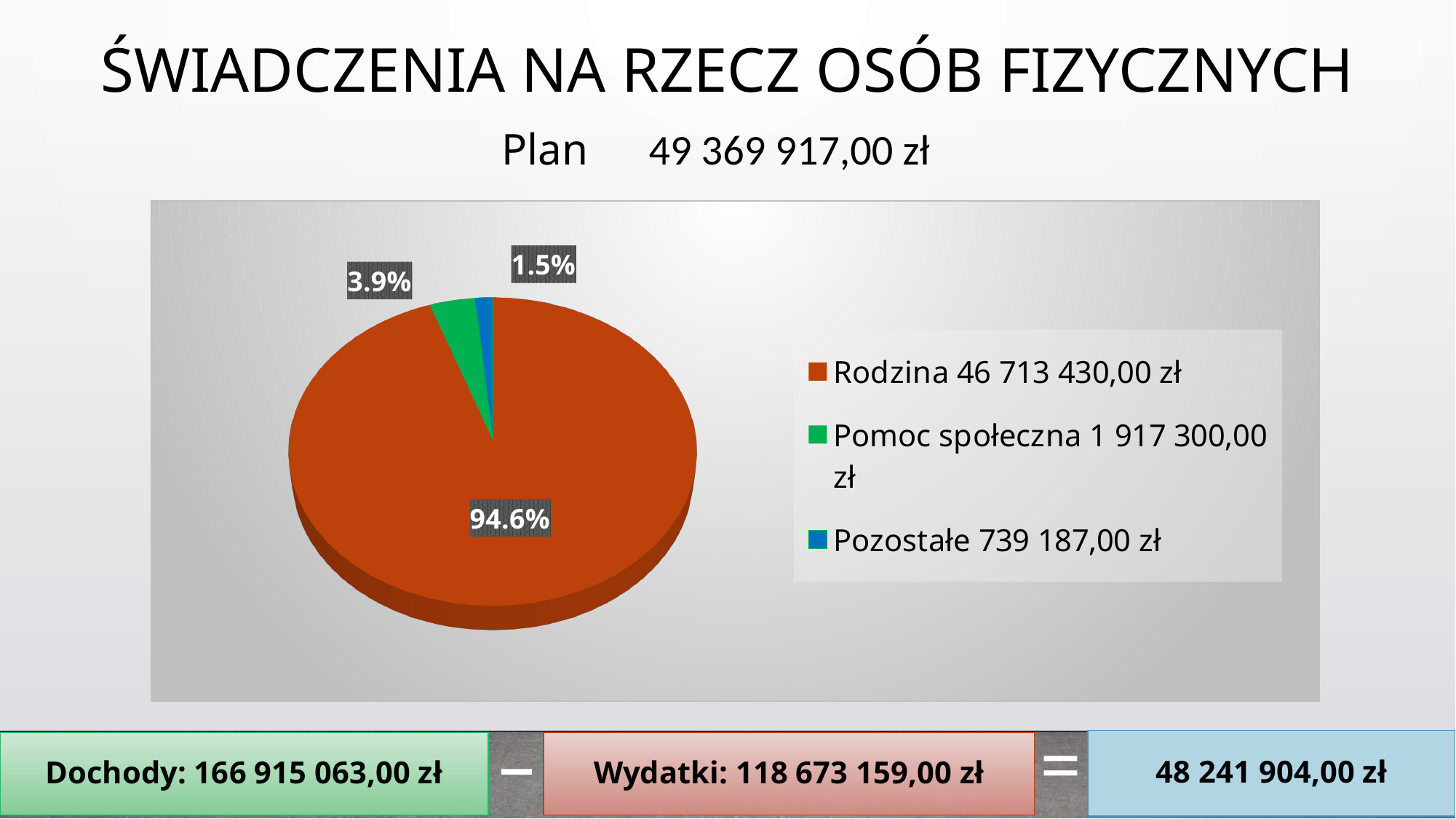
What share of the pie does Pozostałe take? 1.5% What is the difference in percentage points between the Rodzina slice and the Pomoc społeczna slice? 90.7% What share of the pie does Pomoc społeczna take? 3.9% Which category has the smallest slice of the pie? Pozostałe Which category has the largest slice of the pie? Rodzina What value is shown in the legend for Pozostałe? 739 187,00 zł How many slices does the pie chart have? 3 What value is shown in the legend for Rodzina? 46 713 430,00 zł What value is shown in the legend for Pomoc społeczna? 1 917 300,00 zł How many entries does the legend of the pie chart list? 3 What share of the pie does Rodzina take? 94.6% What kind of chart is shown on the slide? pie chart